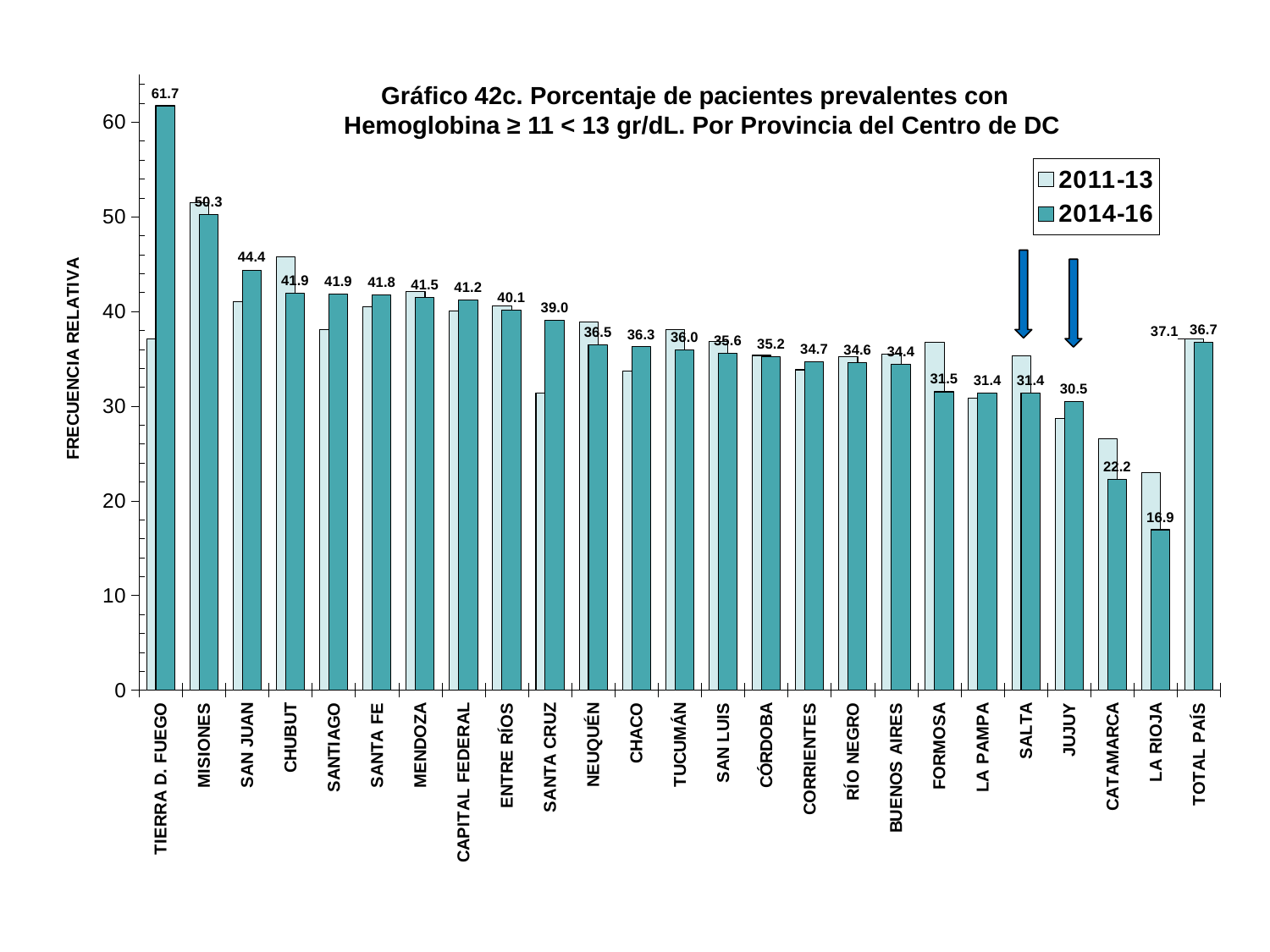
Which province has the highest 2014-16 value? TIERRA D. FUEGO What is the 2011-13 value for TOTAL PAÍS? 37.1 What is the 2014-16 value for TIERRA D. FUEGO? 61.7 Is the 2011-13 value for SANTA CRUZ greater or less than 40? less How many series does the legend list? 2 How many categories are shown on the x axis? 25 What is the 2014-16 value for LA RIOJA? 16.9 What kind of chart is this? bar chart What is the difference between the 2014-16 values for MISIONES and SAN JUAN? 5.9 What is the label of the y axis? FRECUENCIA RELATIVA Which province has the lowest 2014-16 value? LA RIOJA Which is larger, the 2014-16 value for CATAMARCA or for JUJUY? JUJUY